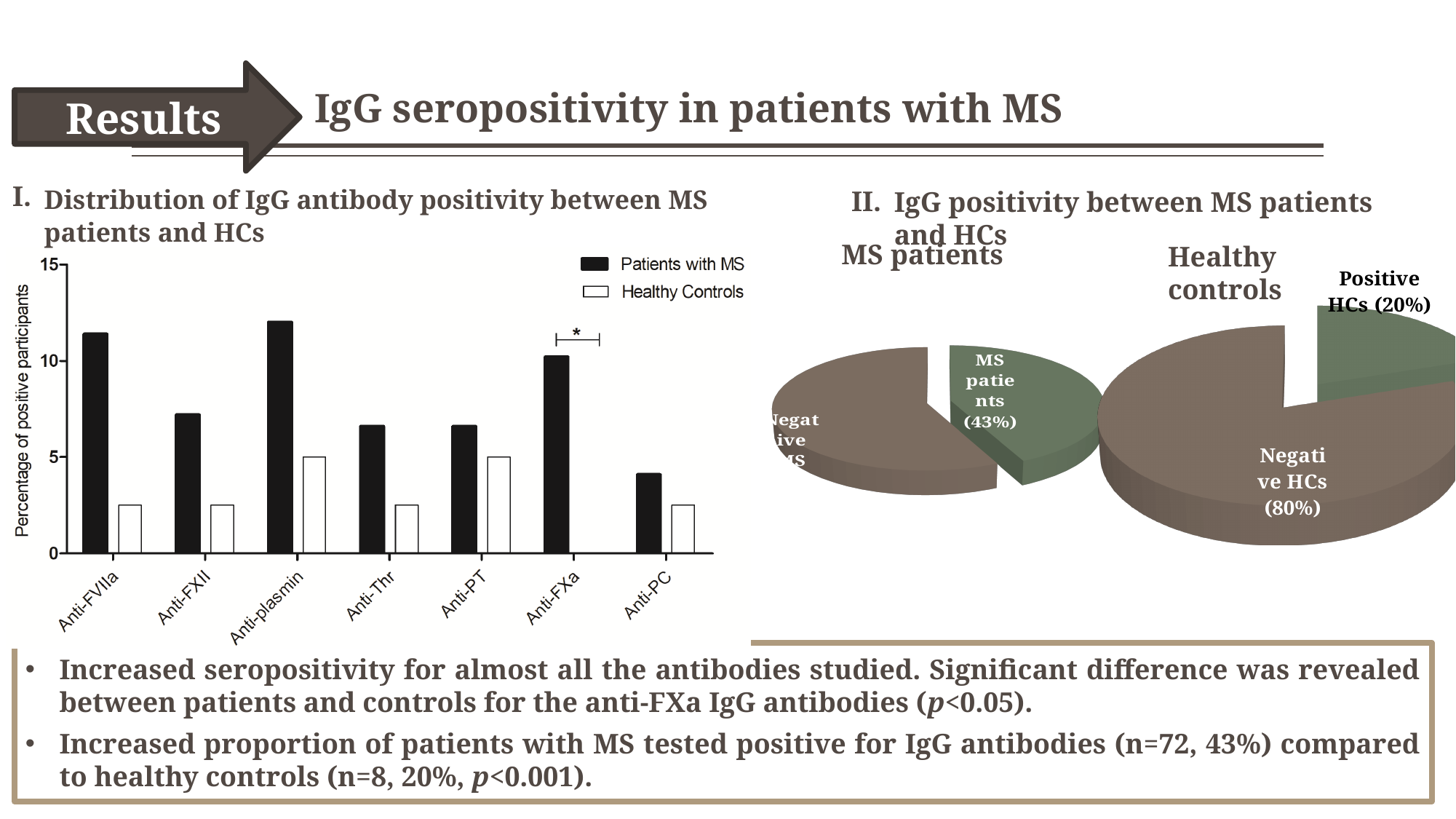
In the 'MS patients' pie chart, what share is labelled for the positive MS patients slice? 43% In chart I (the bar chart), how many series does the legend list? 2 In chart I (the bar chart), is the Patients with MS value for Anti-PC greater or less than 5? less What kind of chart is chart I, 'Distribution of IgG antibody positivity between MS patients and HCs'? bar chart In chart I (the bar chart), how many antibody categories are shown on the x axis? 7 In the 'Healthy controls' pie chart, what share is Positive HCs? 20% In chart I (the bar chart), is the Patients with MS value for Anti-FVIIa greater or less than 10? greater In chart I (the bar chart), which antibody category is marked with an asterisk indicating a significant difference? Anti-FXa In chart I (the bar chart), is the Patients with MS value for Anti-Thr greater or less than 5? greater In chart I (the bar chart), for Anti-FXa, which group has the larger percentage: Patients with MS or Healthy Controls? Patients with MS In the 'Healthy controls' pie chart, what share is Negative HCs? 80% In chart I (the bar chart), which antibody has the lowest percentage for Patients with MS? Anti-PC